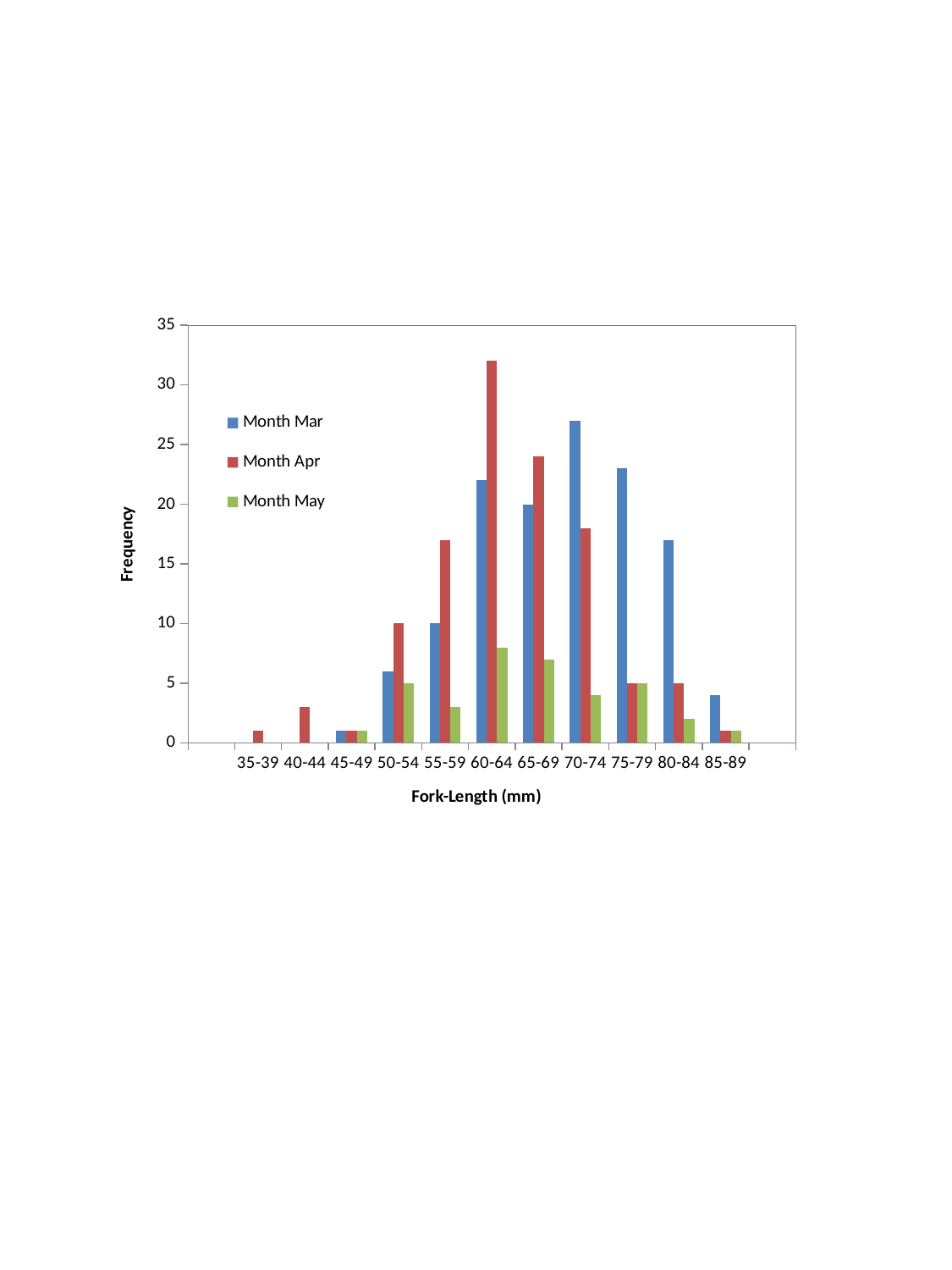
What is the frequency for Month Mar in the 65-69 category? 20 What kind of chart is shown on the slide? Bar chart In which fork-length category is the Month Apr frequency highest? 60-64 In the 70-74 category, which is larger: Month Mar or Month Apr? Month Mar What is the frequency for Month Apr in the 50-54 category? 10 Is the Month May value for 60-64 greater or less than 10? less What is the frequency for Month May in the 50-54 category? 5 In which fork-length category is the Month Mar frequency highest? 70-74 Is the Month Apr value for 60-64 greater or less than 30? greater How many series does the legend list? 3 What is the title of the x axis? Fork-Length (mm) How many fork-length categories are shown on the x axis? 11